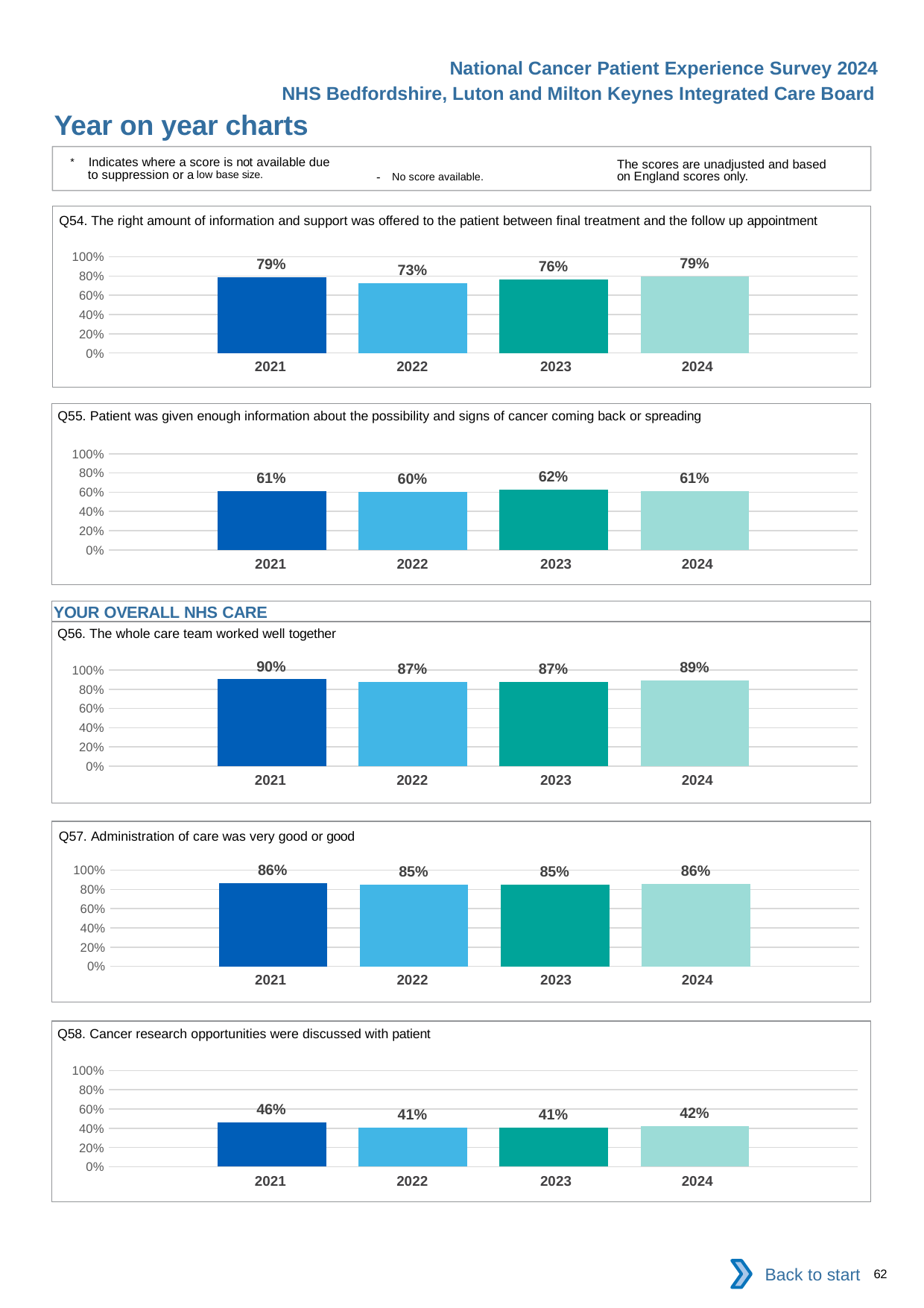
How many years are shown in the Q54 chart? 4 In the Q58 chart, is the value for 2021 greater or less than 60%? less In the Q57 chart, what is the value for 2024? 86% In the Q56 chart, what is the value for 2021? 90% In the Q54 chart, what is the value for 2022? 73% What kind of chart is the Q56 chart? bar chart In the Q58 chart, which year has the highest value? 2021 How many charts are shown on the slide? 5 In the Q55 chart, which year has the highest value? 2023 In the Q54 chart, what is the difference between the 2021 value and the 2022 value? 6% In the Q58 chart, what is the difference between the 2021 value and the 2022 value? 5% In the Q57 chart, which year has the lowest value, 2021 or 2022? 2022